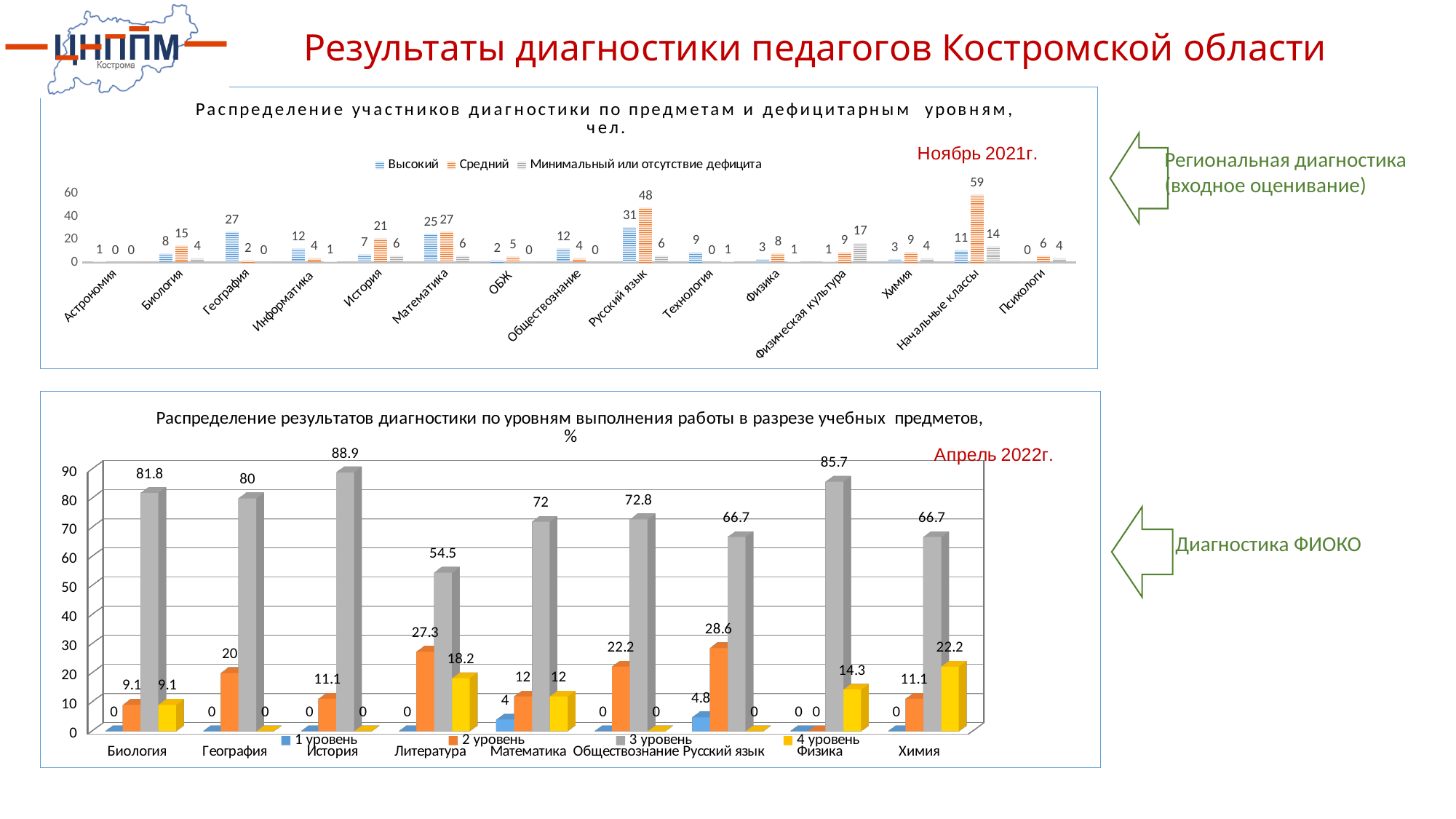
In the bottom chart, how many series does the legend list? 4 In the top chart, how many subject categories are shown on the x axis? 15 What type of chart is the bottom chart? Bar chart In the bottom chart, which subject has the lowest 3 уровень value? Литература In the bottom chart (Распределение результатов диагностики по уровням выполнения работы), what is the 3 уровень value for История? 88.9 In the top chart, how many series does the legend list? 3 In the top chart (Распределение участников диагностики по предметам и дефицитарным уровням), what is the value of Средний for Русский язык? 48 In the top chart, what is the difference between the Средний and Высокий values for Начальные классы? 48 In the bottom chart, which is larger: the 2 уровень value for Русский язык or for Литература? Русский язык In the top chart, what is the value of Высокий for География? 27 In the top chart, which subject has the highest Средний value? Начальные классы In the bottom chart, what is the 4 уровень value for Химия? 22.2